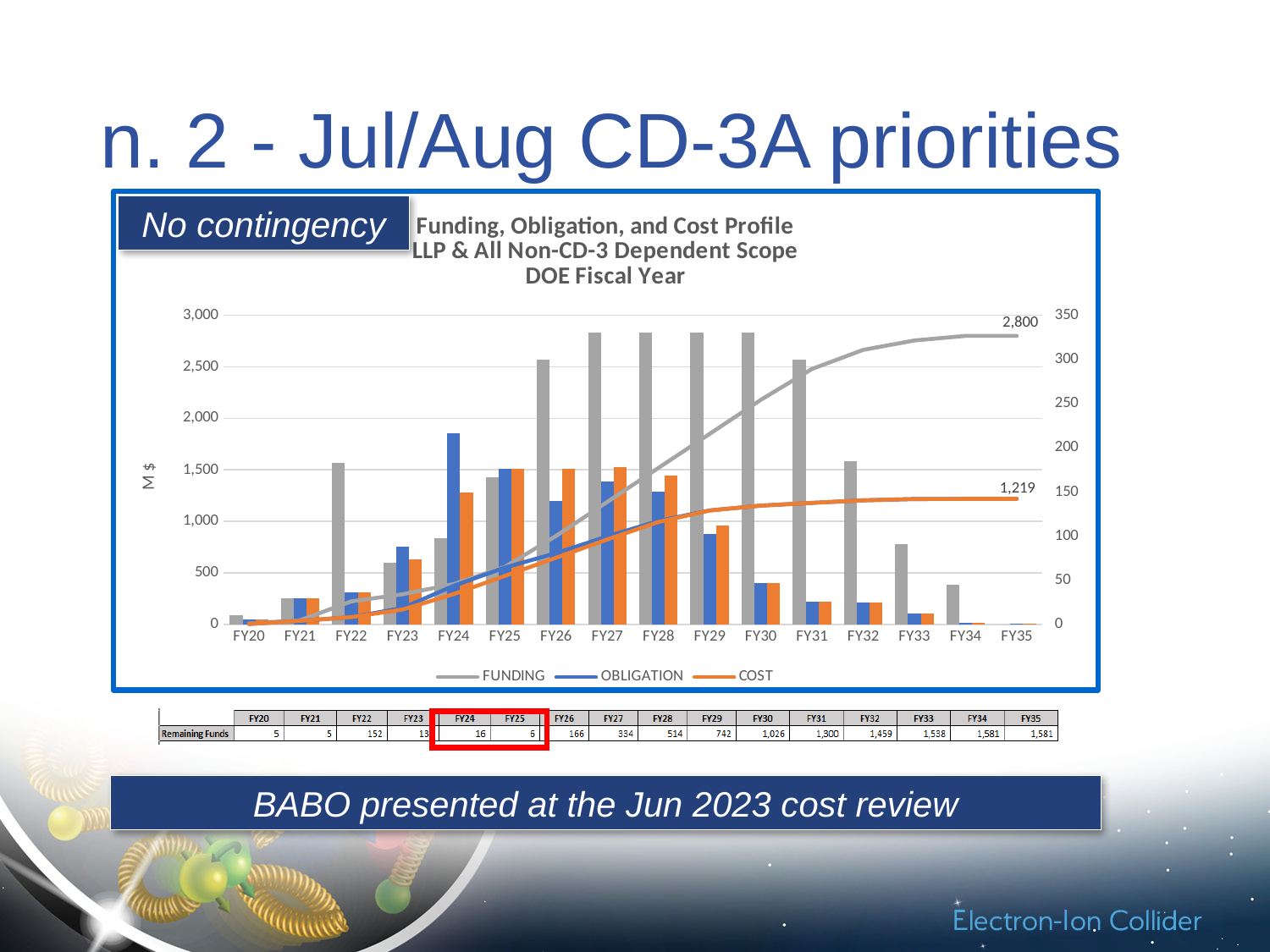
At FY35, which line has the larger labeled value, FUNDING or COST? FUNDING What is the difference between the labeled FUNDING value (2,800) and the labeled COST value (1,219) at FY35? 1,581 What value is labeled at the end of the COST line in FY35? 1,219 Is the value of the OBLIGATION line at FY25 greater or less than 1,000 on the left axis? less How many fiscal years are shown on the x axis of the chart? 16 What value is labeled at the end of the FUNDING line in FY35? 2,800 What is the title of the chart? Funding, Obligation, and Cost Profile LLP & All Non-CD-3 Dependent Scope DOE Fiscal Year How many series does the chart legend list? 3 Does the FUNDING line rise or fall from FY20 to FY35? rise Is the value of the FUNDING line at FY31 greater or less than 2,000 on the left axis? greater What kind of chart is shown on the slide? combined bar and line chart What is the label on the left vertical axis of the chart? M $